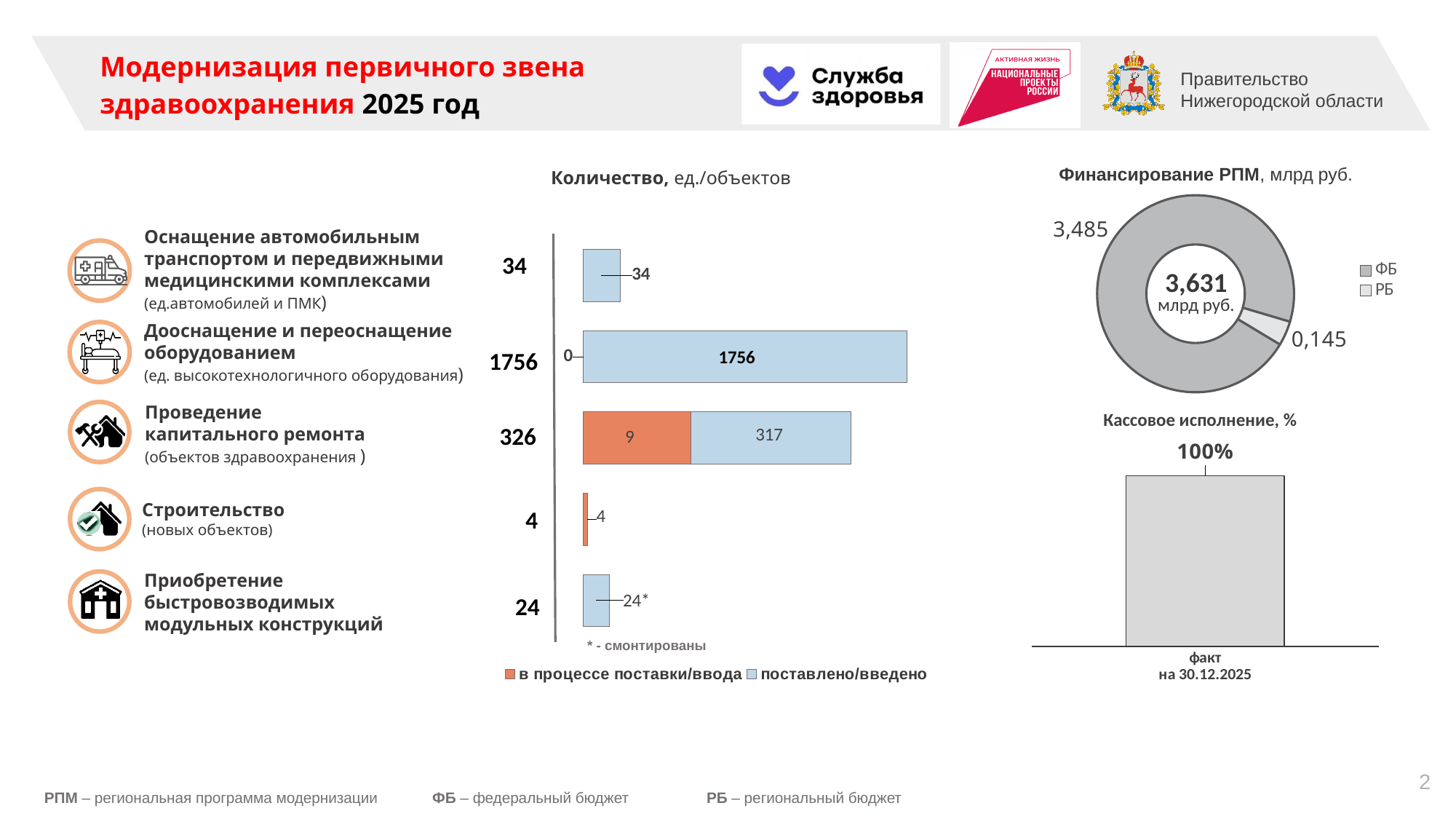
In the 'Кассовое исполнение, %' chart, what is the value for 'факт на 30.12.2025'? 100% In the 'Финансирование РПМ, млрд руб.' chart, what is the value for ФБ? 3,485 In the 'Количество, ед./объектов' chart, what is the value for 'в процессе поставки/ввода' for 'Проведение капитального ремонта'? 9 In the 'Количество, ед./объектов' chart, which category has the highest total value? Дооснащение и переоснащение оборудованием In the 'Количество, ед./объектов' chart, what is the difference between the totals for 'Дооснащение и переоснащение оборудованием' and 'Проведение капитального ремонта'? 1430 In the 'Количество, ед./объектов' chart, which category has the lowest total value? Строительство What kind of chart is 'Финансирование РПМ, млрд руб.'? Donut (pie) chart In the 'Количество, ед./объектов' chart, how many categories are plotted? 5 In the 'Количество, ед./объектов' chart, what is the total for 'Проведение капитального ремонта'? 326 In the 'Количество, ед./объектов' chart, how many series does the legend list? 2 In the 'Количество, ед./объектов' chart, what is the value for 'поставлено/введено' for 'Проведение капитального ремонта'? 317 In the 'Финансирование РПМ, млрд руб.' chart, which is larger, ФБ or РБ? ФБ